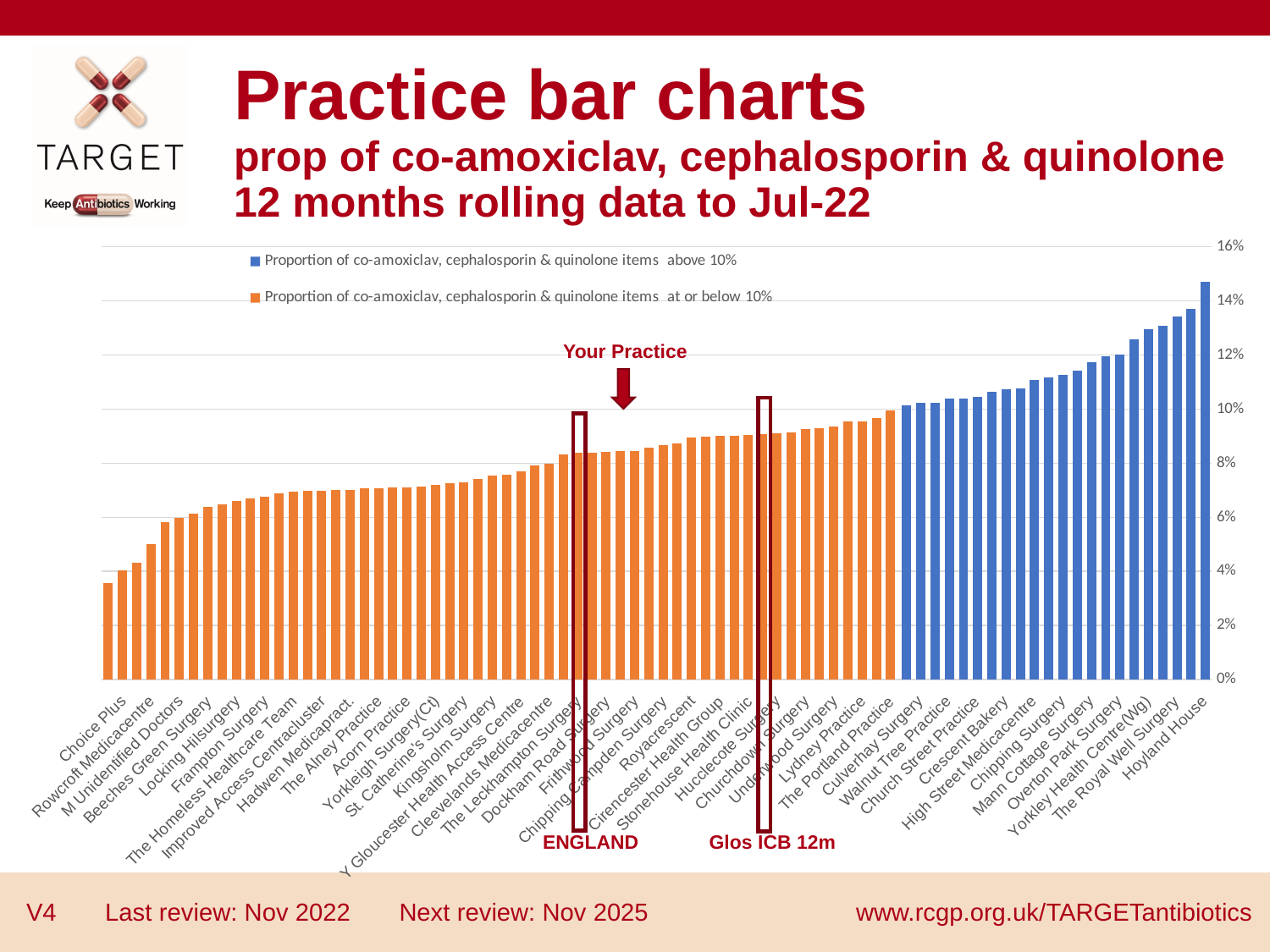
What colour are the bars for practices with a proportion above 10%? blue Do the bar values rise or fall from left to right along the x axis? rise Is the value for Frampton Surgery greater or less than 6%? greater Is the value for Hoyland House greater or less than 14%? greater Which two benchmark bars are outlined in red boxes on the chart? ENGLAND and Glos ICB 12m What kind of chart is shown on the slide? bar chart Which practice has the highest proportion of co-amoxiclav, cephalosporin & quinolone items? Hoyland House How many series does the legend list? 2 Which has a larger value, Hoyland House or Choice Plus? Hoyland House Is the value for Rowcroft Medicacentre greater or less than 6%? less